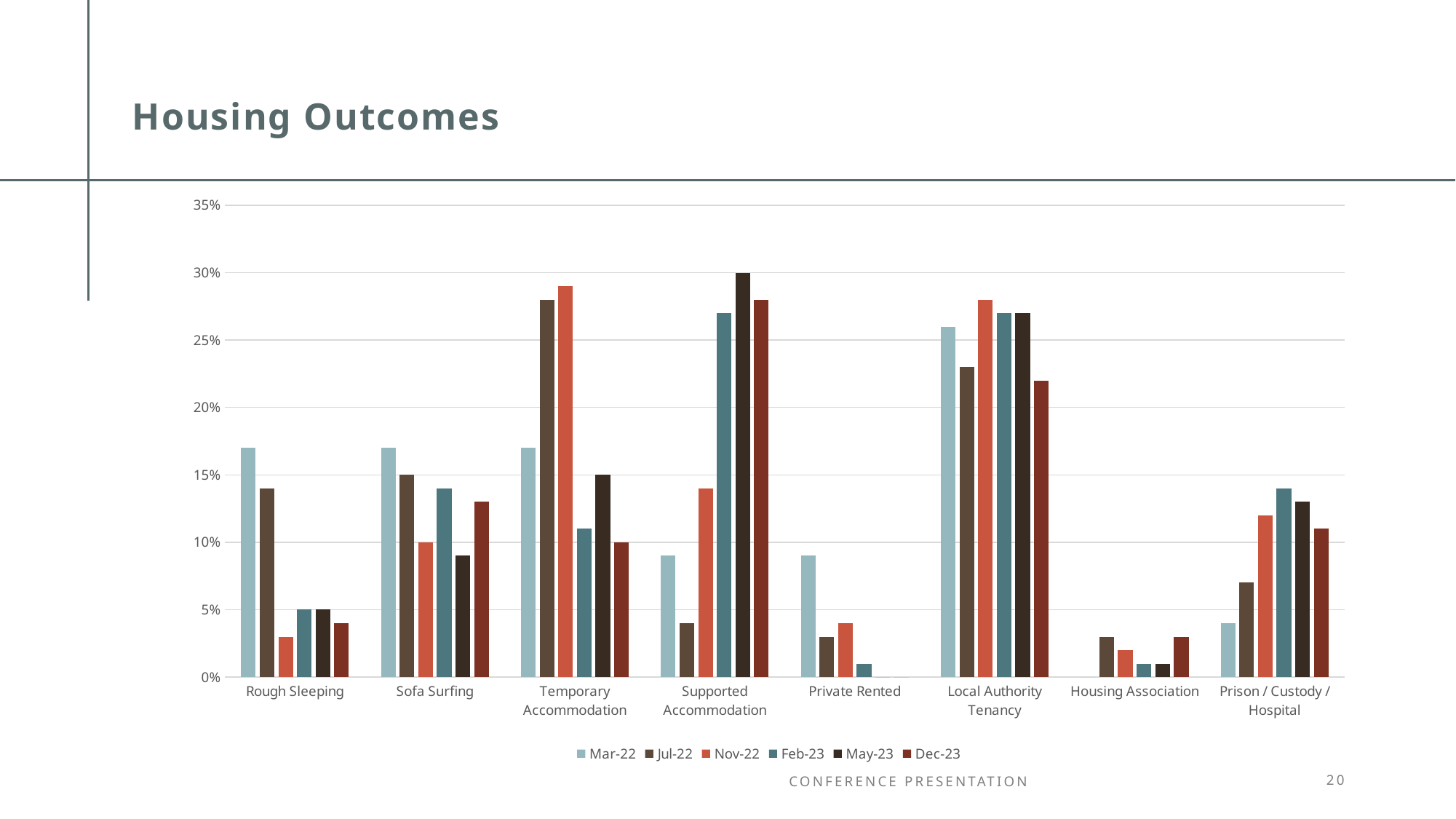
How many housing outcome categories are shown on the x axis? 8 Which series has the highest value in the Supported Accommodation category? May-23 Which series has the lowest value in the Private Rented category? May-23 and Dec-23 (both 0%) What is the value for Feb-23 in the Rough Sleeping category? 5% Is the value for Mar-22 in the Local Authority Tenancy category greater or less than 25%? greater What kind of chart is shown on the slide? bar chart How many series does the legend list? 6 What is the value for Jul-22 in the Sofa Surfing category? 15% Which is larger: the Mar-22 value for Rough Sleeping or the Mar-22 value for Supported Accommodation? Rough Sleeping Is the value for Feb-23 in the Private Rented category greater or less than 5%? less What is the title of the chart on the slide? Housing Outcomes What is the value for May-23 in the Supported Accommodation category? 30%